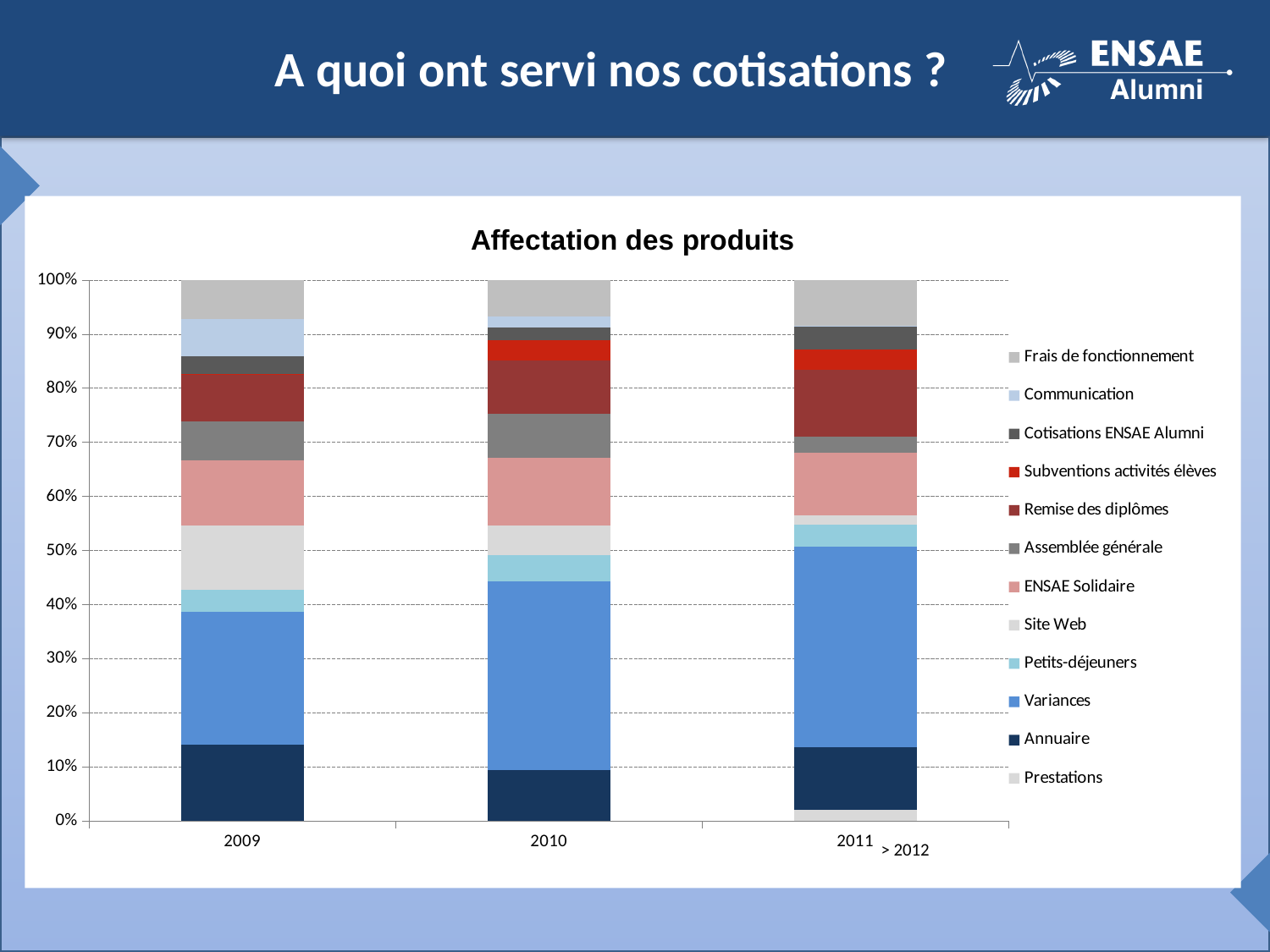
What kind of chart is shown on the slide? stacked bar chart What is the title of the chart? Affectation des produits How many years are shown on the x axis of the chart? 3 How many series does the legend list? 12 Is the share of Annuaire in 2009 greater or less than 10%? greater Which year has the largest share for Variances? 2011 Which year has the largest share for Site Web? 2009 Is the Variances share larger in 2009 or in 2011? 2011 Does the share of Variances rise or fall from 2009 to 2011? rise Is the share of Variances in 2011 greater or less than 40%? less Which series is listed last in the legend? Prestations Is the share of Variances in 2009 greater or less than 30%? less